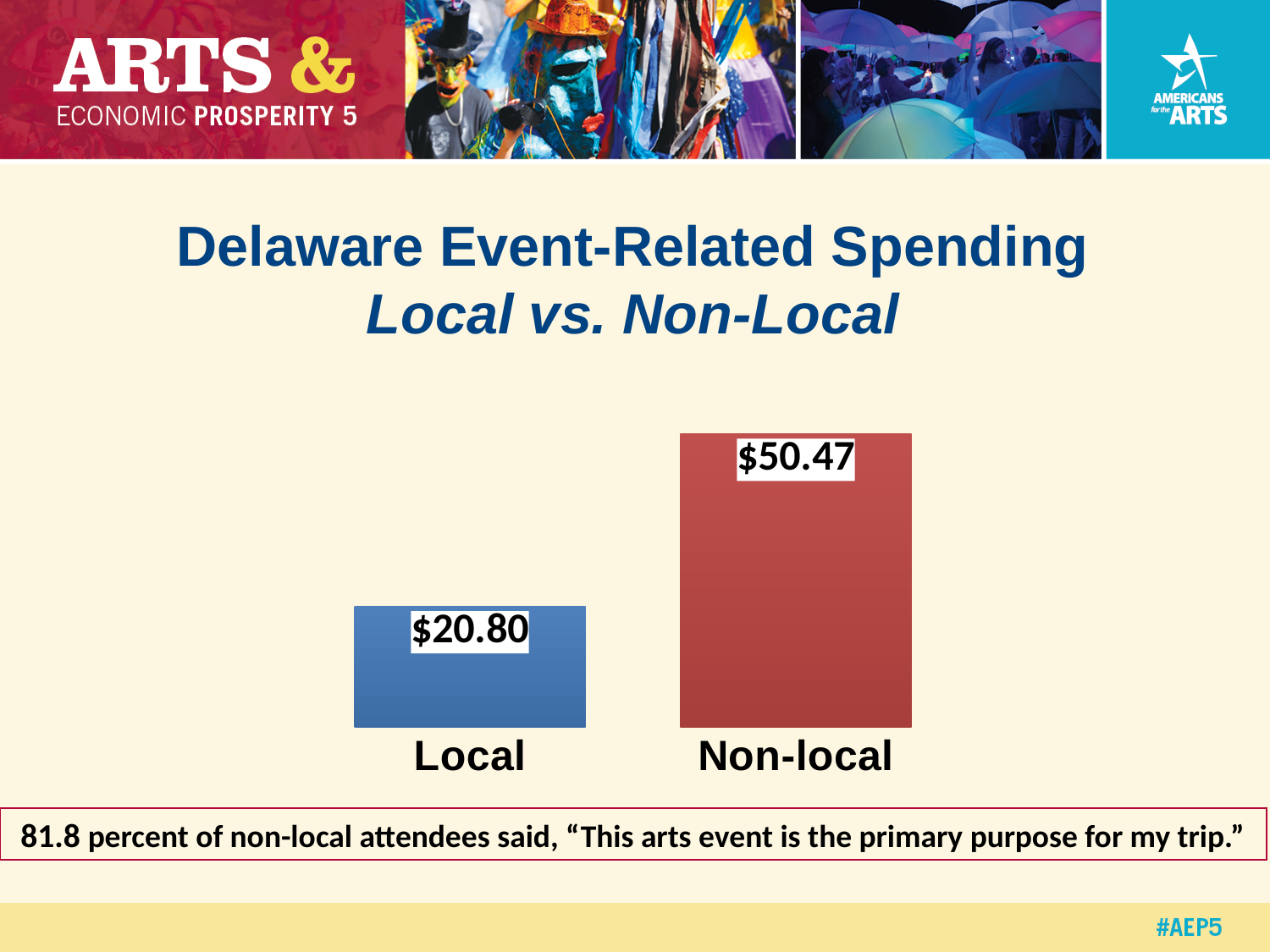
What kind of chart is shown on the slide? bar chart Which category has the higher event-related spending? Non-local What colour is the bar for Non-local attendees? red How many categories are shown in the chart? 2 What is the title of the chart on the slide? Delaware Event-Related Spending Local vs. Non-Local What is the event-related spending value for Local attendees? $20.80 Is the spending for Non-local attendees larger or smaller than for Local attendees? larger What is the difference between Non-local and Local event-related spending? $29.67 What is the event-related spending value for Non-local attendees? $50.47 Which category has the lower event-related spending? Local